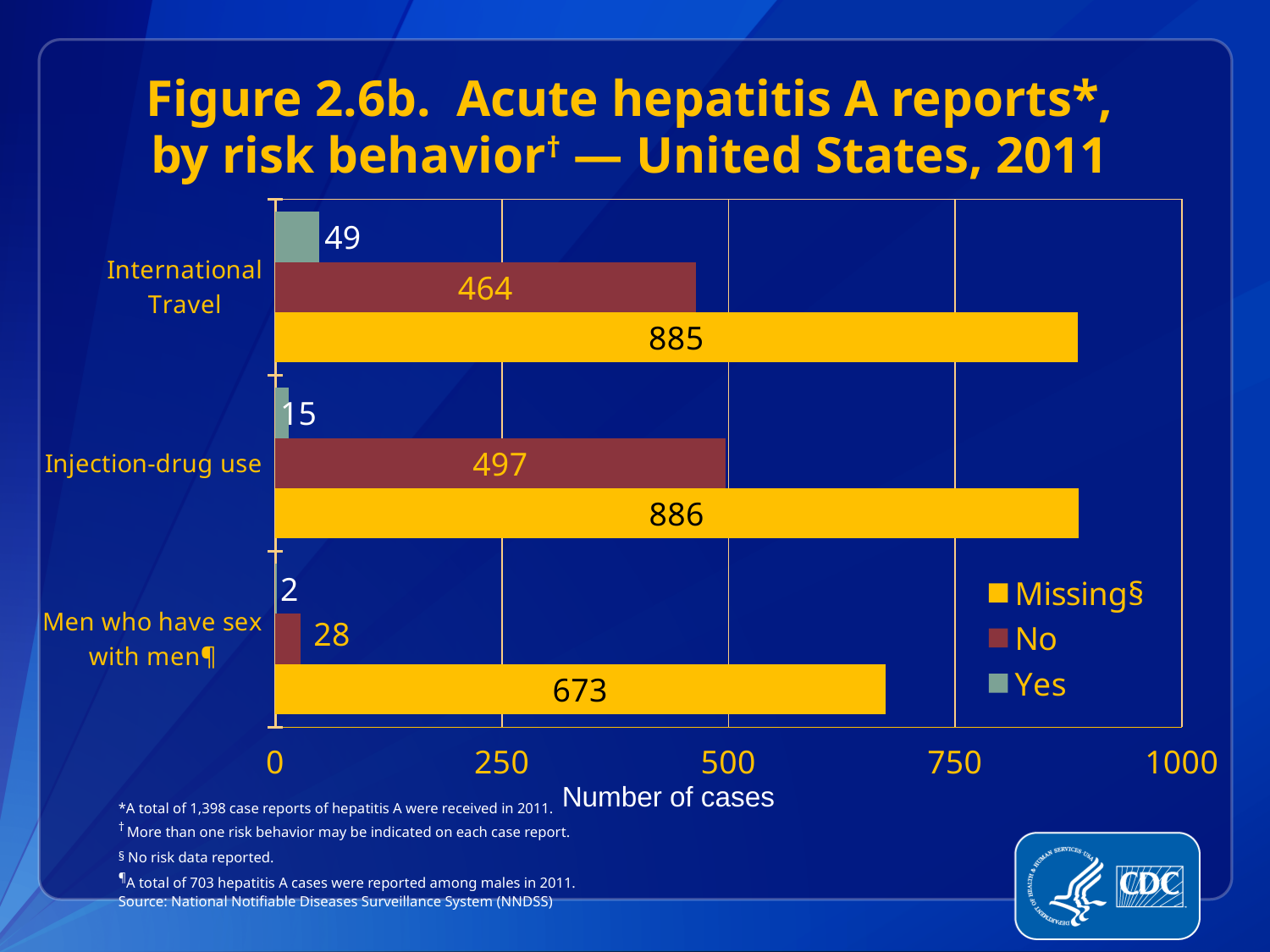
How many series does the legend list? 3 What is the number of cases with 'No' for Injection-drug use? 497 How many risk behavior categories are shown on the chart? 3 Is the 'Missing' value for Men who have sex with men greater or less than 750? less Which risk behavior has the highest number of 'Missing' cases? Injection-drug use Which is larger: the 'Yes' value for International Travel or the 'Yes' value for Injection-drug use? International Travel What is the number of cases with 'Missing' for Men who have sex with men? 673 Which risk behavior has the lowest number of 'Yes' cases? Men who have sex with men What is the number of cases with 'Yes' for International Travel? 49 What is the label of the x axis? Number of cases What is the difference between the 'No' values for Injection-drug use and International Travel? 33 What kind of chart is shown on the slide? bar chart